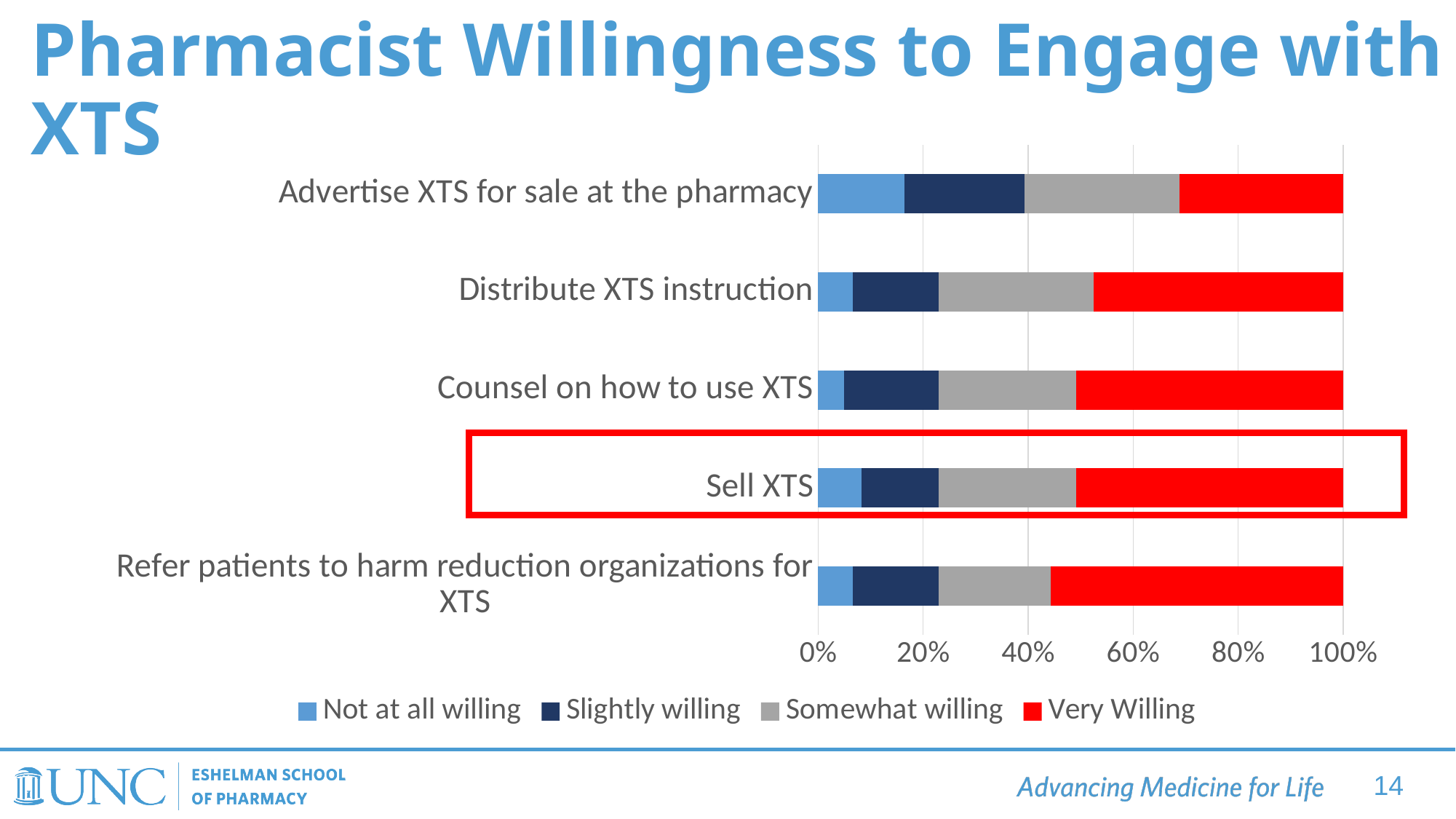
Which category has the smallest 'Very Willing' segment? Advertise XTS for sale at the pharmacy Which category has the largest 'Very Willing' segment? Refer patients to harm reduction organizations for XTS How many series does the legend list? 4 Which has a larger 'Somewhat willing' segment: 'Advertise XTS for sale at the pharmacy' or 'Refer patients to harm reduction organizations for XTS'? Advertise XTS for sale at the pharmacy Is the 'Very Willing' share for 'Refer patients to harm reduction organizations for XTS' greater or less than 40%? greater Which category is highlighted with a red box on the slide? Sell XTS How many categories (activities) are plotted on the chart? 5 What kind of chart is shown on the slide? Stacked bar chart Is the 'Very Willing' share for 'Advertise XTS for sale at the pharmacy' greater or less than 40%? less What does each stacked bar total on the x axis? 100% Which category has the largest 'Not at all willing' segment? Advertise XTS for sale at the pharmacy Which has a larger 'Not at all willing' segment: 'Advertise XTS for sale at the pharmacy' or 'Sell XTS'? Advertise XTS for sale at the pharmacy